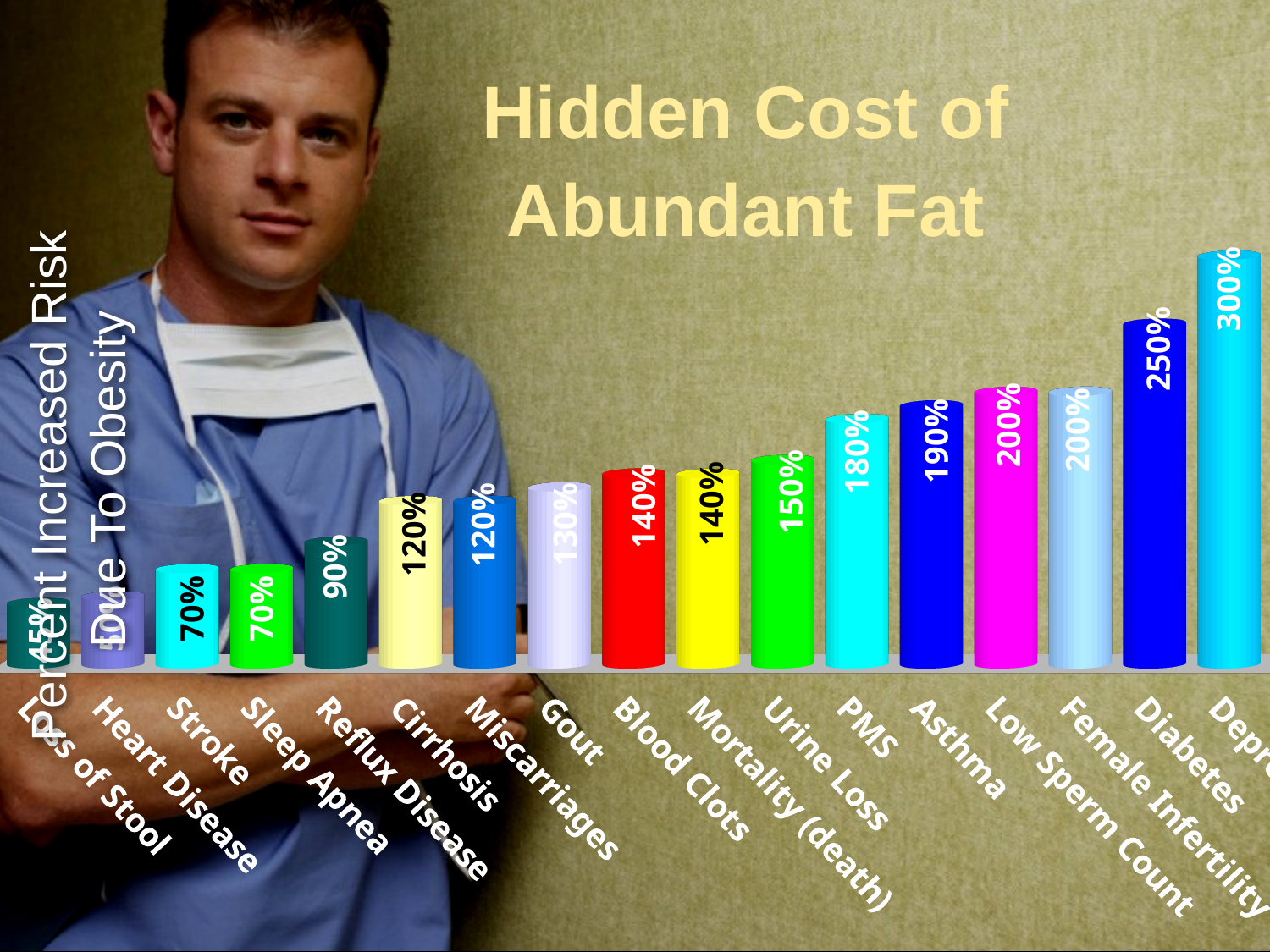
Do the values generally rise or fall from left to right across the categories? Rise What is the difference between the values for PMS and Cirrhosis? 60% Which has a higher value, PMS or Gout? PMS What is the percent increased risk shown for Stroke? 70% What is the value shown for Urine Loss? 150% What value is shown for Reflux Disease? 90% What is the value for Asthma? 190% What is the title of the chart? Hidden Cost of Abundant Fat What is the value for Gout? 130% What kind of chart is shown on the slide? Bar chart What is the difference between the values for Diabetes and Asthma? 60% What is the value shown for Diabetes? 250%